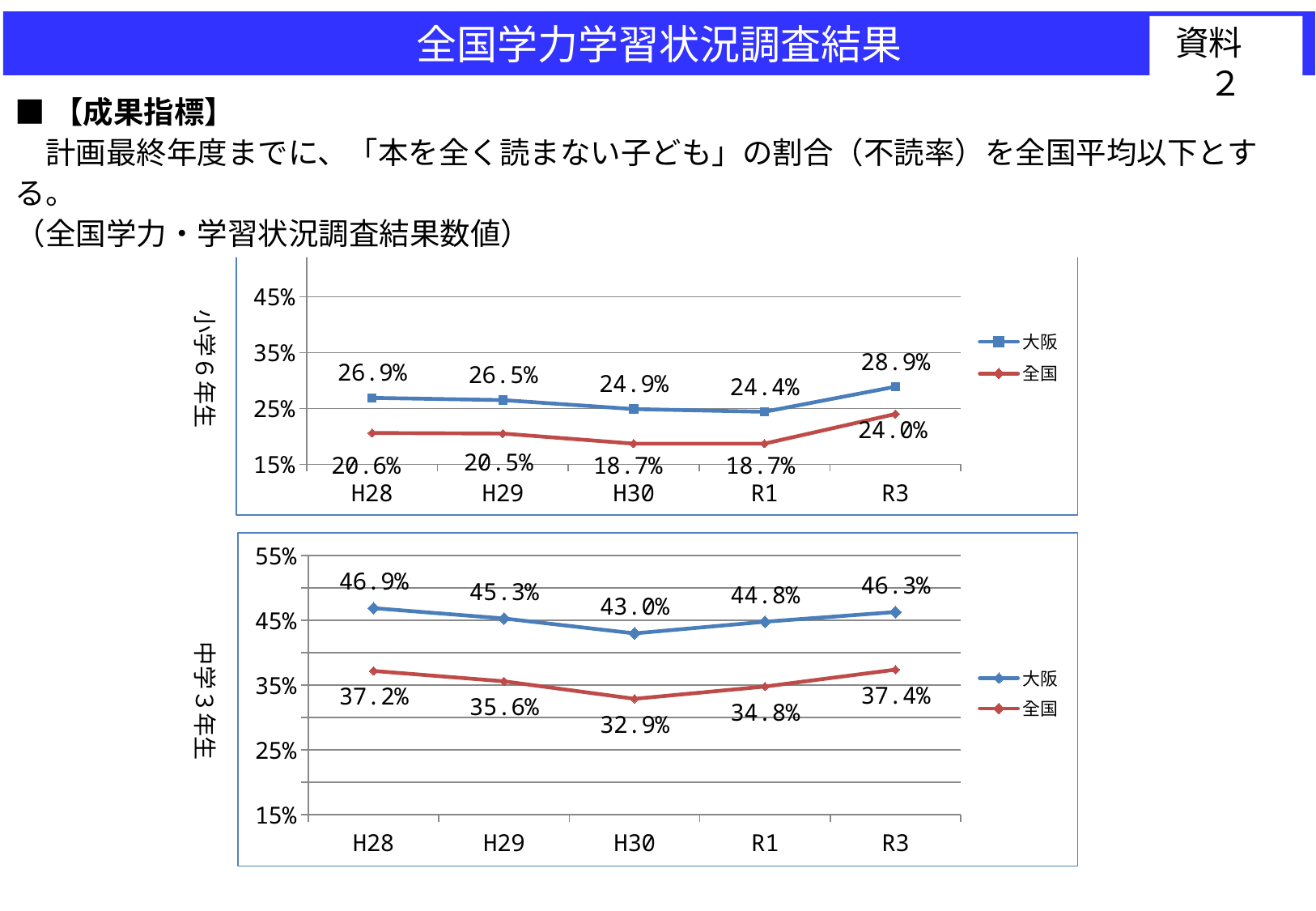
In the bottom chart (中学3年生), what is the value for 全国 at H29? 35.6% How many years (categories) are plotted on the x axis of the bottom chart (中学3年生)? 5 In the top chart (小学6年生), which year has the highest value for 大阪? R3 In the bottom chart (中学3年生), what is the value for 大阪 at H30? 43.0% In the bottom chart (中学3年生), which year has the lowest value for 全国? H30 In the bottom chart (中学3年生), what is the difference between 大阪 and 全国 at H28? 9.7% What kind of chart is the top chart (小学6年生)? Line chart In the top chart (小学6年生), how many series does the legend list? 2 In the top chart (小学6年生), what is the value for 大阪 at H28? 26.9% In the top chart (小学6年生), what is the value for 全国 at R3? 24.0% In the top chart (小学6年生), what is the difference between 大阪 and 全国 at R1? 5.7% In the bottom chart (中学3年生), which is larger at R3: 大阪 or 全国? 大阪